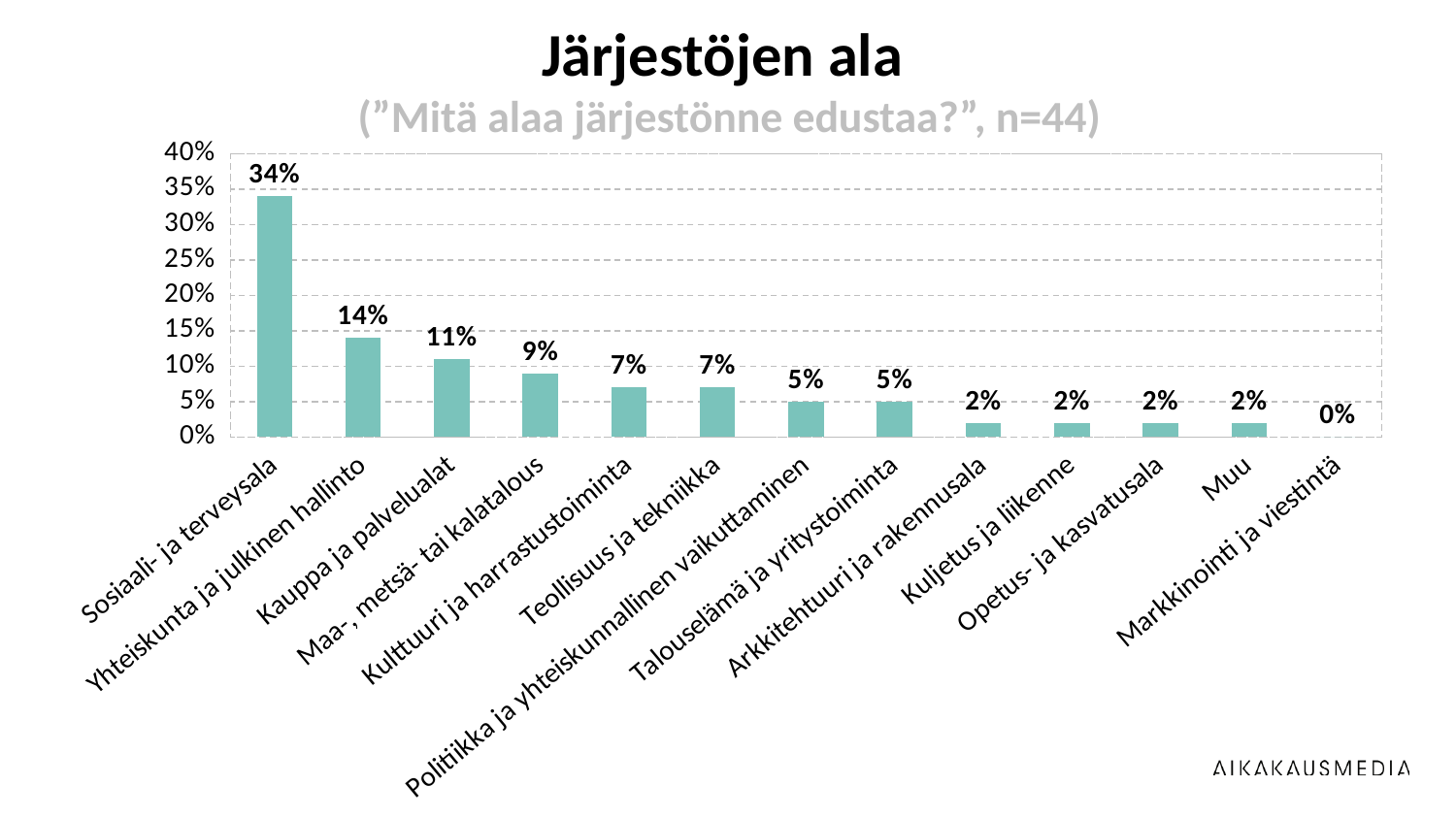
What is the difference between Sosiaali- ja terveysala and Yhteiskunta ja julkinen hallinto? 20% How many categories are shown on the x axis? 13 What is the value for Talouselämä ja yritystoiminta? 5% Which category has the lowest value? Markkinointi ja viestintä What is the value for Sosiaali- ja terveysala? 34% Which is larger, Maa-, metsä- tai kalatalous or Kulttuuri ja harrastustoiminta? Maa-, metsä- tai kalatalous What is the value for Markkinointi ja viestintä? 0% Which category has the highest value? Sosiaali- ja terveysala What is the title of the chart? Järjestöjen ala What kind of chart is this? Bar chart What is the value for Kauppa ja palvelualat? 11% Do the values rise or fall from left to right along the x axis? Fall